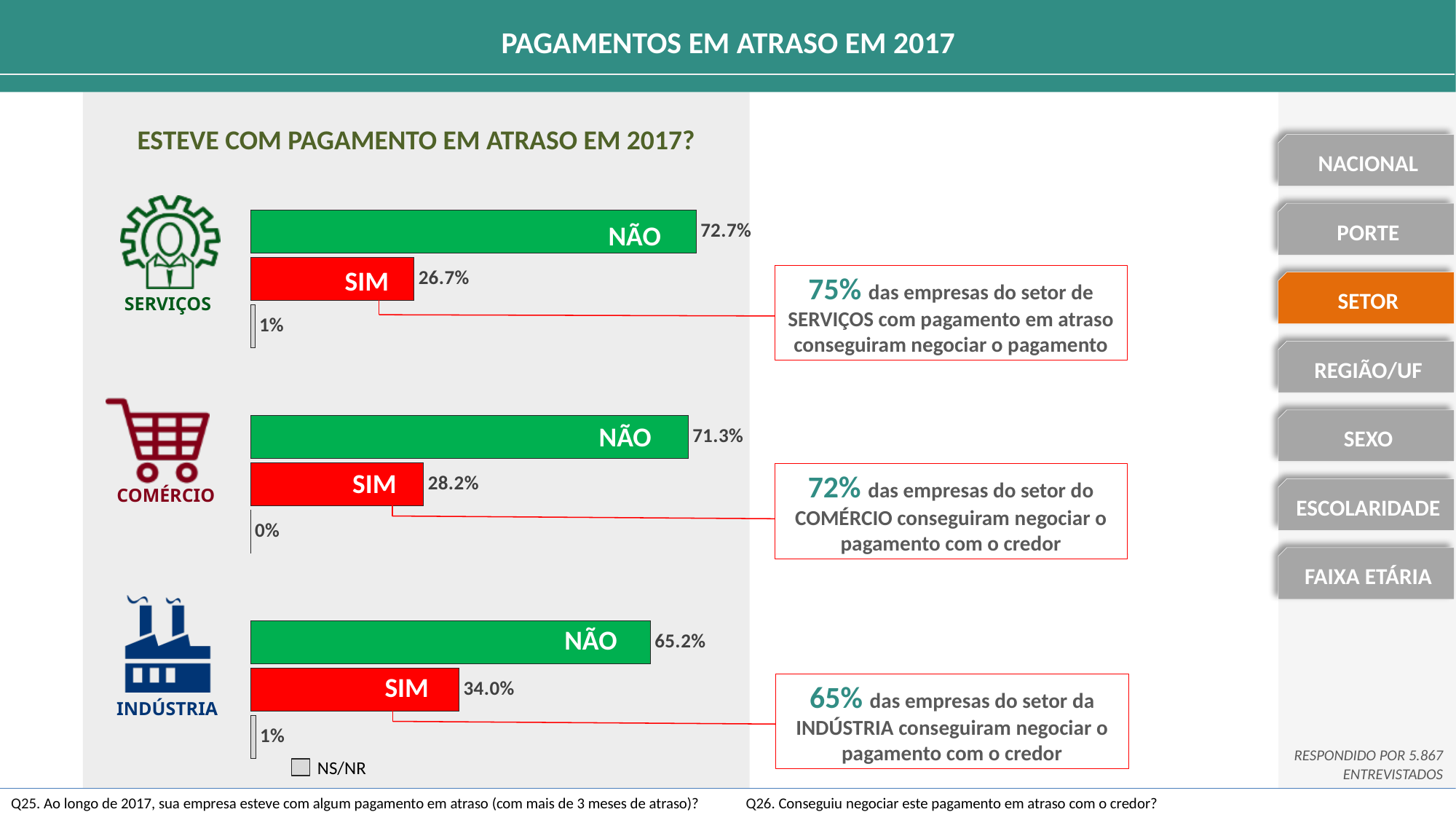
In the COMÉRCIO chart, what is the value for NS/NR? 0% Which sector has the highest SIM percentage across the three charts? INDÚSTRIA In the COMÉRCIO chart, what percentage answered SIM? 28.2% What colour are the NÃO bars in the charts? Green How many response categories are shown in each sector's chart? 3 In the INDÚSTRIA chart, what percentage answered NÃO? 65.2% In the INDÚSTRIA chart, what is the difference between the NÃO and SIM percentages? 31.2% Is the SIM percentage larger for COMÉRCIO or for SERVIÇOS? COMÉRCIO In the SERVIÇOS chart, what percentage answered SIM? 26.7% What type of chart is used to show the responses for each sector? Bar chart Which sector has the lowest NÃO percentage across the three charts? INDÚSTRIA In the SERVIÇOS chart, what percentage answered NÃO? 72.7%